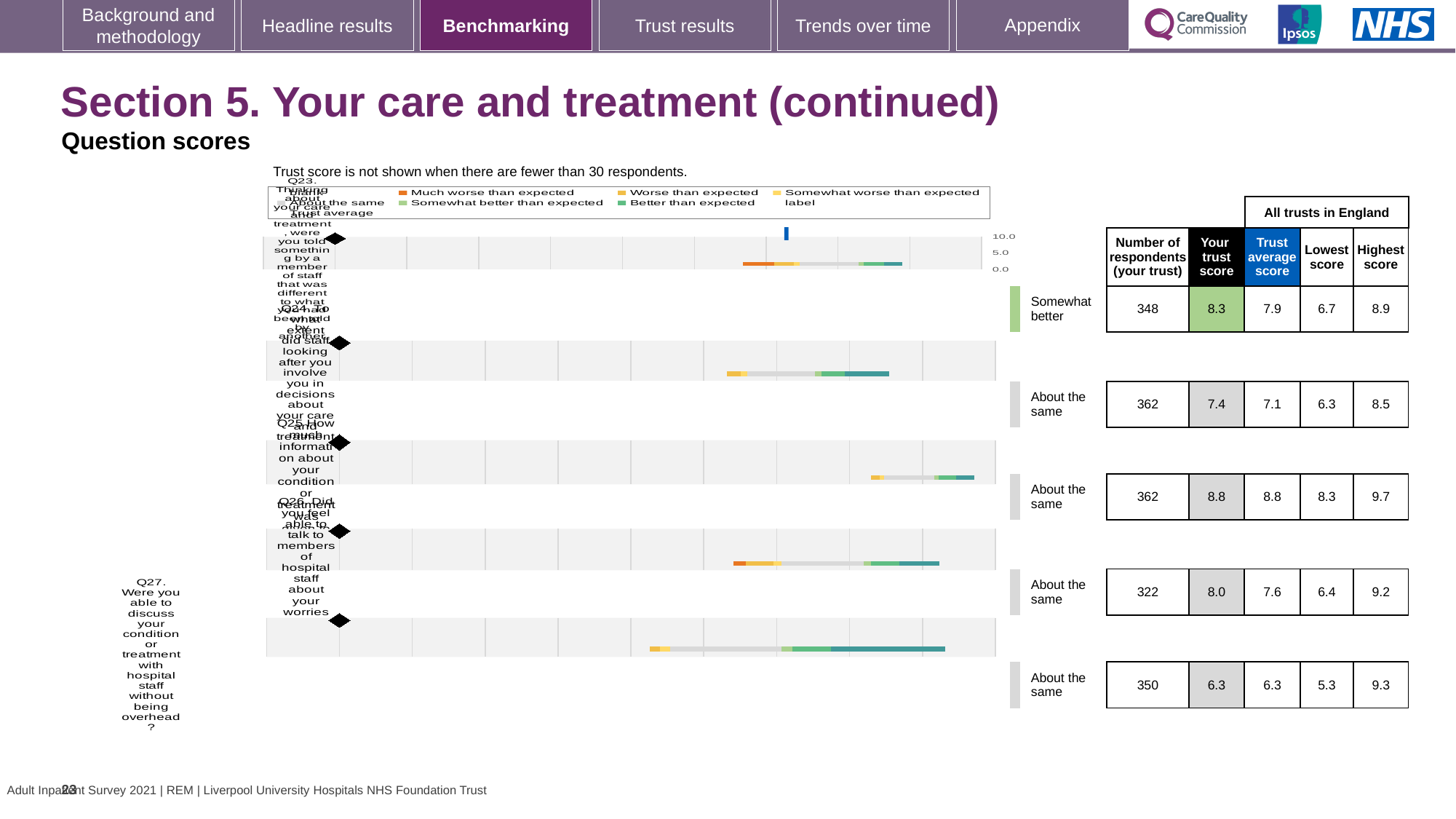
How many questions (Q23 to Q27) are plotted in the chart? 5 Which question has the lowest 'Your trust score'? Q27 For Q26, which is larger: the trust's score or the trust average score? Your trust score What is the 'Your trust score' shown for Q23? 8.3 What is the lowest score across all trusts in England shown for Q27? 5.3 What is the trust average score shown for Q24? 7.1 For Q23, what is the difference between the trust's score and the trust average score? 0.4 Which benchmark category is shown for Q23? Somewhat better Which question has the highest 'Your trust score'? Q25 What kind of chart is used to show the question scores on this slide? bar chart How many respondents are shown for Q26? 322 What is the highest score across all trusts in England shown for Q25? 9.7